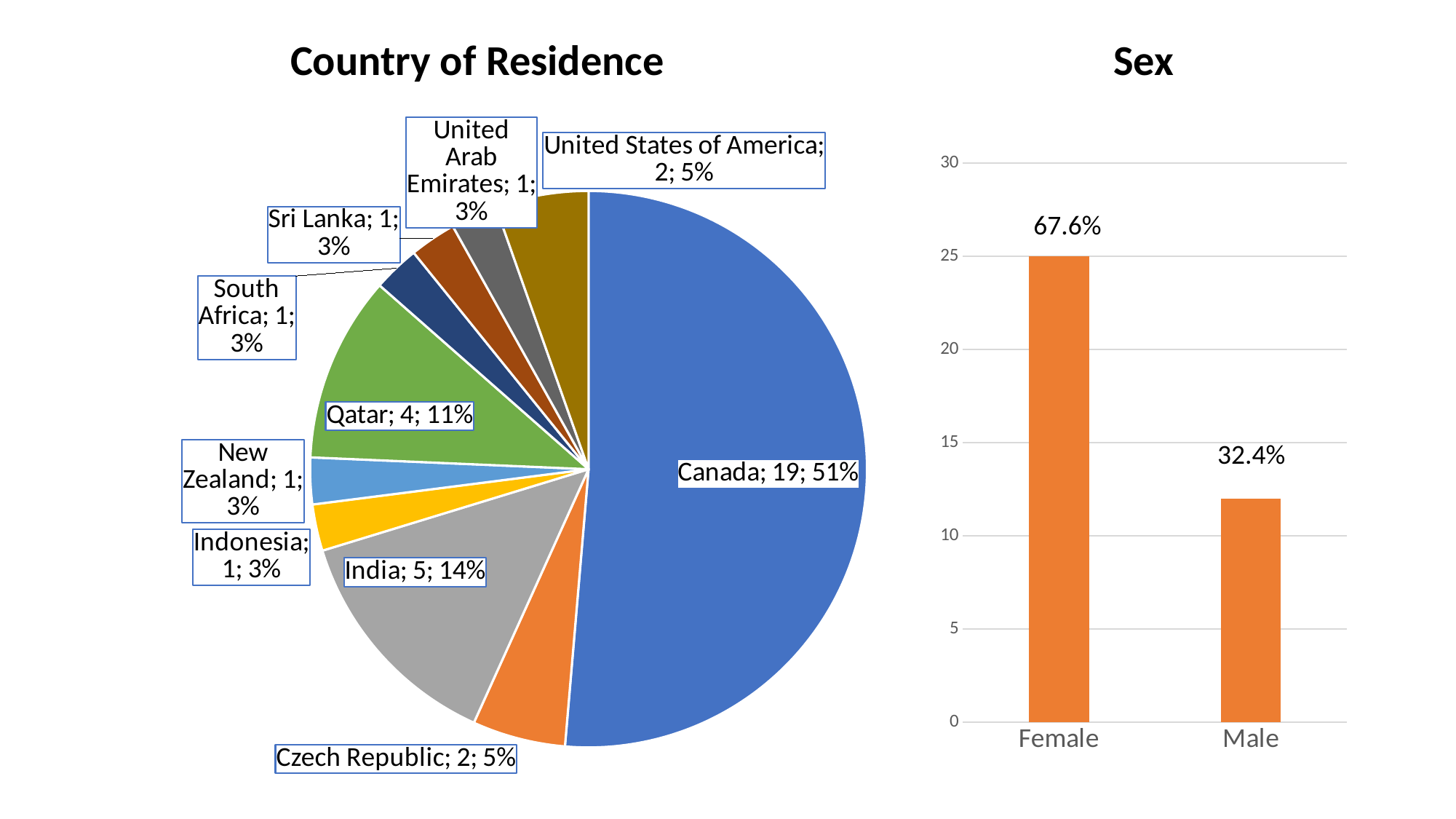
In the Country of Residence pie chart, what percentage is shown for Qatar? 11% In the Country of Residence pie chart, what share of the pie does India represent? 14% In the Country of Residence pie chart, what is the difference in count between Canada and India? 14 In the Country of Residence pie chart, which country has the largest slice? Canada In the Sex chart, is the value for Male greater or less than 15? less In the Country of Residence pie chart, how many countries are shown? 10 In the Sex chart, what percentage is shown for Female? 67.6% What kind of chart is the Sex chart? Bar chart In the Sex chart, what percentage is shown for Male? 32.4% What kind of chart is the Country of Residence chart? Pie chart In the Country of Residence pie chart, how many respondents are from Canada? 19 In the Country of Residence pie chart, which has more respondents, Qatar or Czech Republic? Qatar